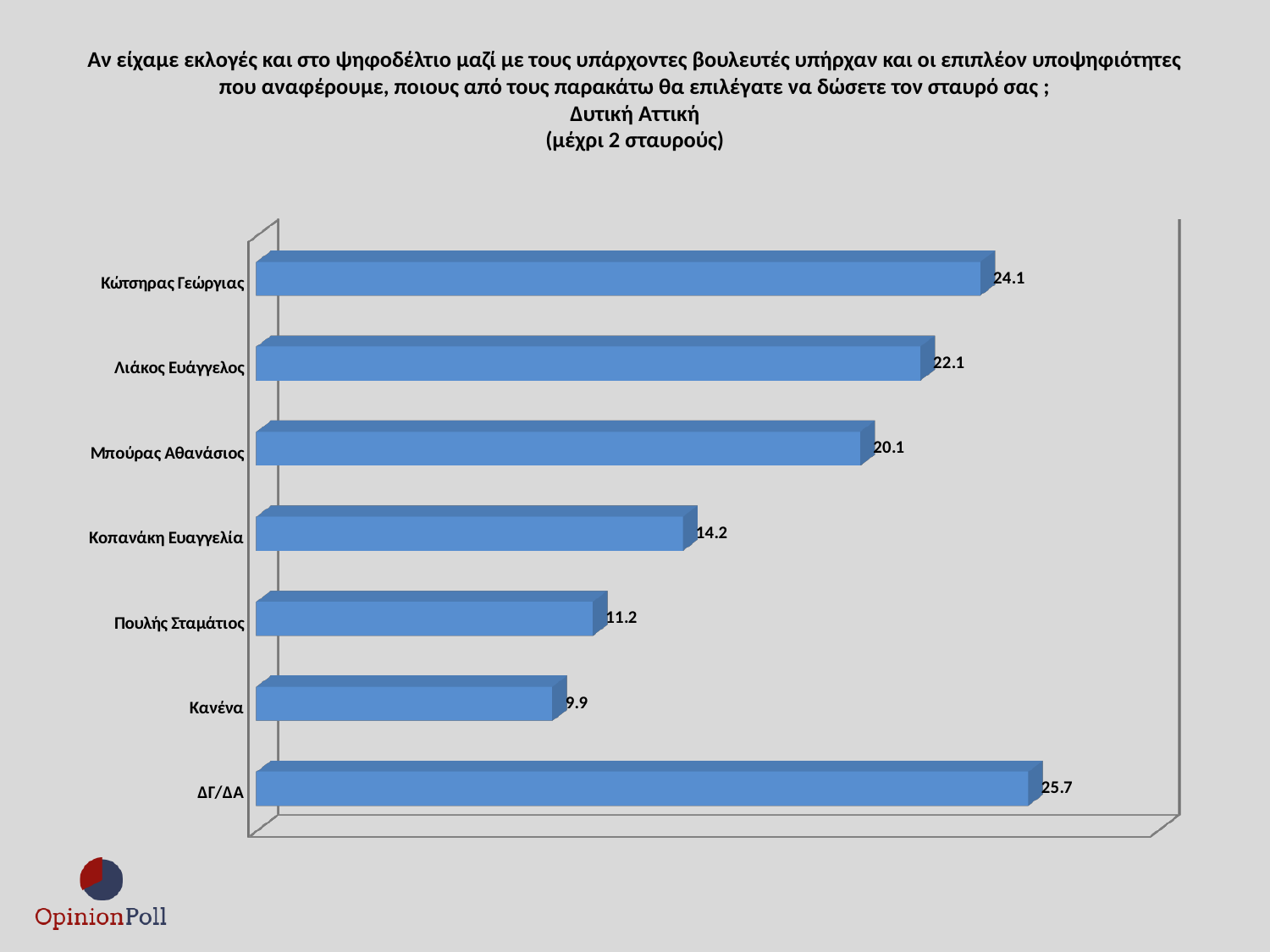
How many categories are shown in the chart? 7 What is the value for Κανένα? 9.9 What is the value for Μπούρας Αθανάσιος? 20.1 Which category has the highest value? ΔΓ/ΔΑ What is the value for Κοπανάκη Ευαγγελία? 14.2 What is the value for Λιάκος Ευάγγελος? 22.1 What kind of chart is shown on the slide? Bar chart Which category has the lowest value? Κανένα Which is larger, the value for Πουλής Σταμάτιος or the value for Κοπανάκη Ευαγγελία? Κοπανάκη Ευαγγελία Which region does the chart title say the results are for? Δυτική Αττική What is the difference between the values for Κώτσηρας Γεώργιας and Λιάκος Ευάγγελος? 2.0 What is the value for Κώτσηρας Γεώργιας? 24.1